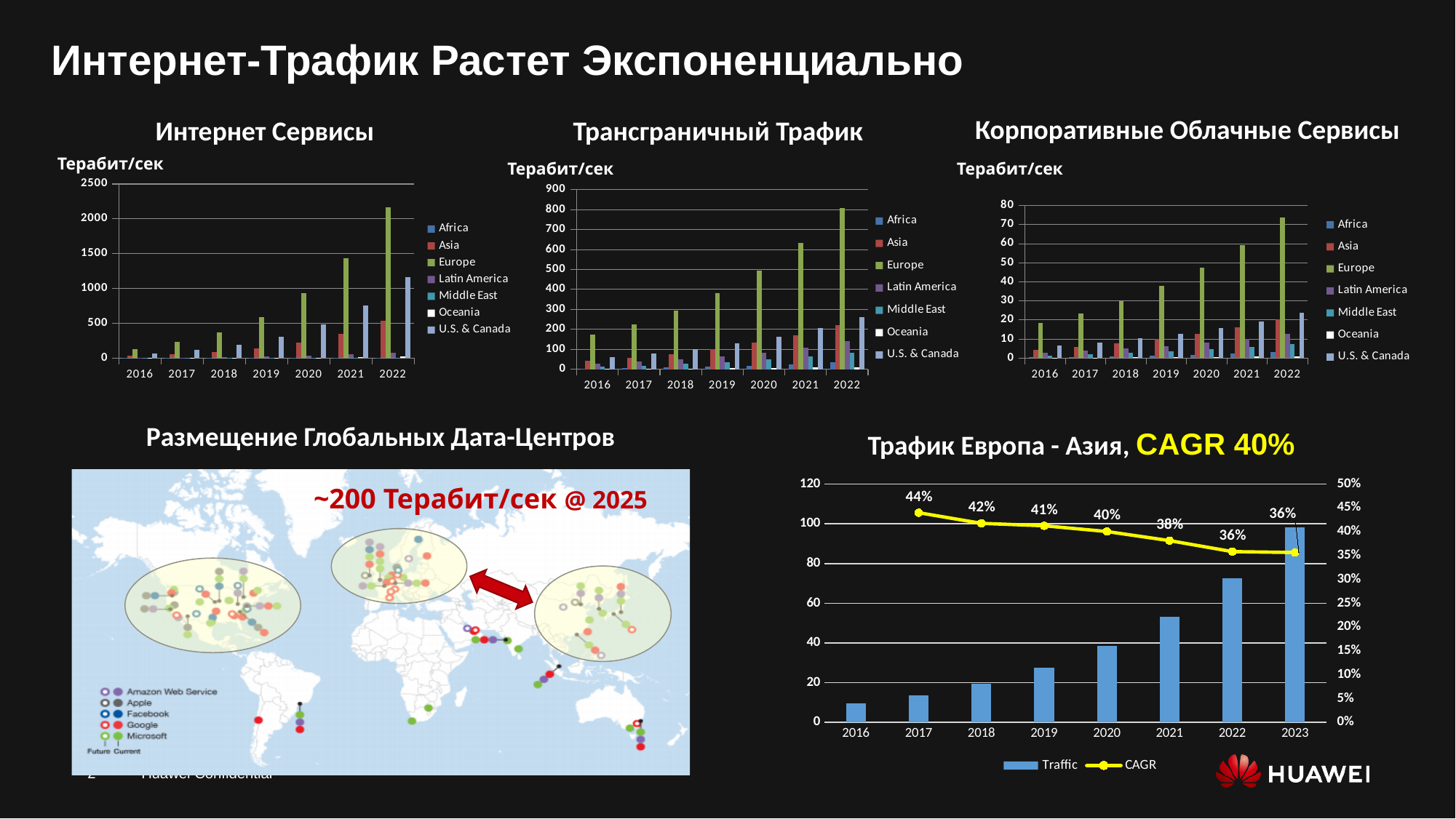
In the 'Интернет Сервисы' chart, is the value for Europe in 2022 greater or less than 2000? greater In the 'Трафик Европа - Азия, CAGR 40%' chart, does the CAGR line rise or fall from 2017 to 2023? fall How many series does the legend of the 'Трафик Европа - Азия, CAGR 40%' chart list? 2 What kind of chart is the 'Корпоративные Облачные Сервисы' chart? bar chart In the 'Интернет Сервисы' chart, which region has the highest value in 2022? Europe How many years are shown on the x axis of the 'Трансграничный Трафик' chart? 7 In the 'Трансграничный Трафик' chart, is the value for Europe in 2021 greater or less than 600? greater In the 'Трансграничный Трафик' chart, does the value for Europe rise or fall from 2016 to 2022? rise In the 'Трафик Европа - Азия, CAGR 40%' chart, what is the difference between the CAGR in 2017 and the CAGR in 2022? 8% In the 'Корпоративные Облачные Сервисы' chart, is the value for Europe in 2022 greater or less than 70? greater How many series does the legend of the 'Интернет Сервисы' chart list? 7 In the 'Трафик Европа - Азия, CAGR 40%' chart, what is the CAGR value for 2017? 44%